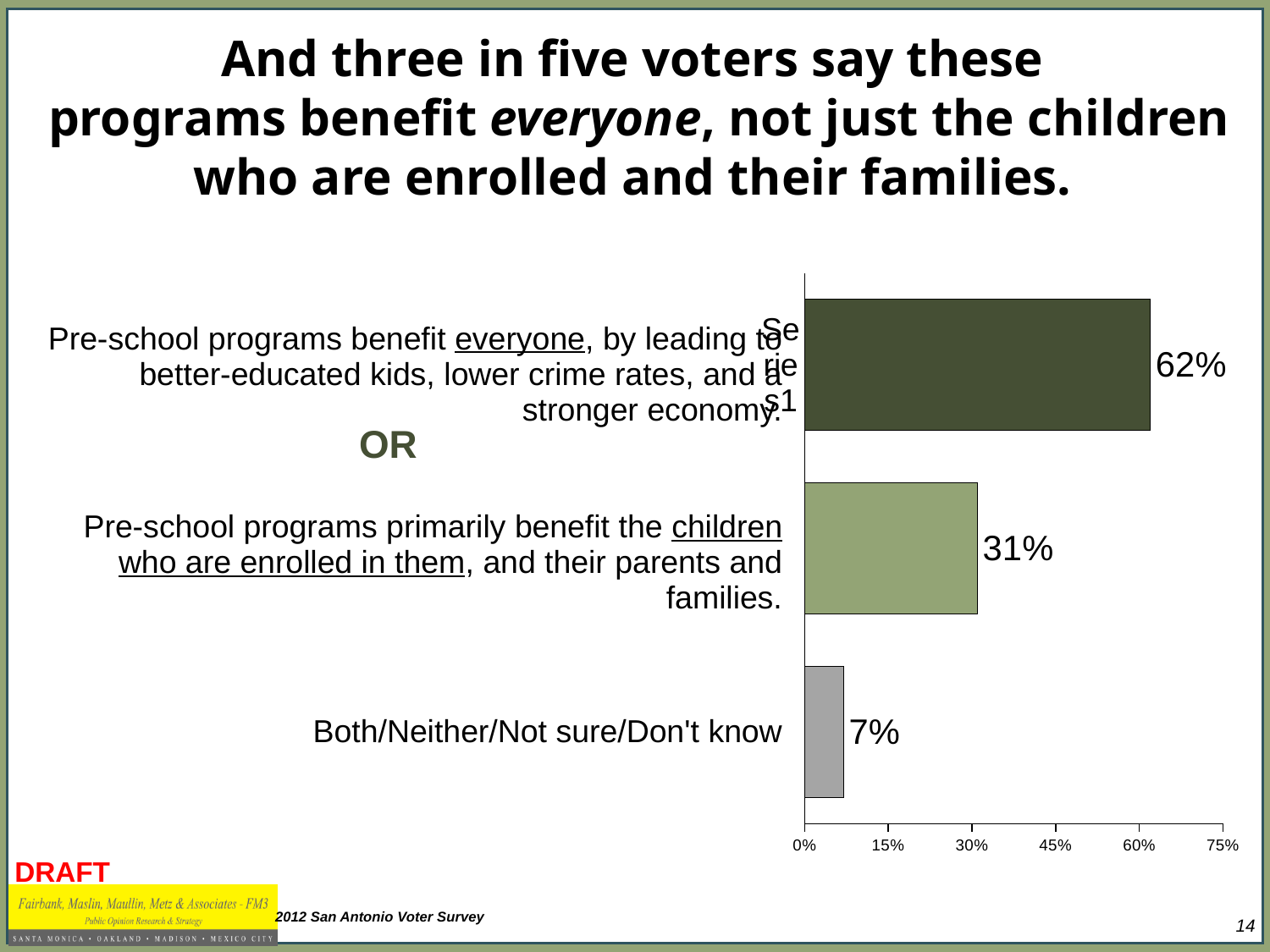
What percentage of voters say pre-school programs benefit everyone, by leading to better-educated kids, lower crime rates, and a stronger economy? 62% What is the difference in percentage points between the 'primarily benefit the children who are enrolled' response and the Both/Neither/Not sure/Don't know response? 24 percentage points Is the value for the 'benefit everyone' response greater or less than 60%? greater What is the difference in percentage points between the 'benefit everyone' response and the 'primarily benefit the children who are enrolled' response? 31 percentage points Which is larger: the share saying programs benefit everyone or the share saying they primarily benefit enrolled children and their families? Benefit everyone Which response category has the lowest value? Both/Neither/Not sure/Don't know What percentage of voters say pre-school programs primarily benefit the children who are enrolled in them, and their parents and families? 31% What percentage of voters answered Both/Neither/Not sure/Don't know? 7% How many response categories are shown in the chart? 3 What type of chart is shown on the slide? Bar chart Which response category has the highest value? Pre-school programs benefit everyone, by leading to better-educated kids, lower crime rates, and a stronger economy. What is the maximum value shown on the chart's percentage axis? 75%